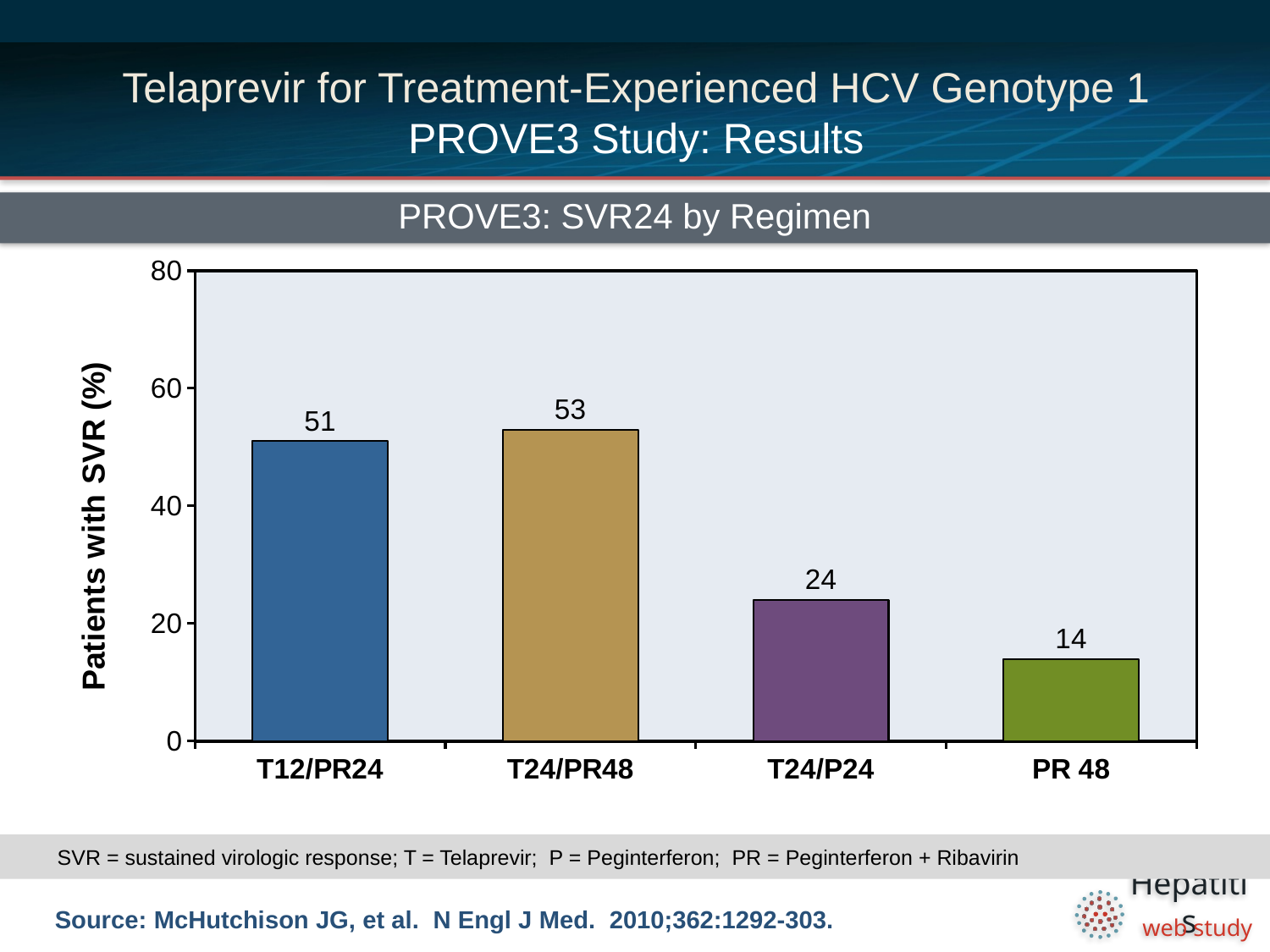
What is the difference between the values for T24/PR48 and PR 48? 39 What is the value for T24/PR48? 53 What is the value for T24/P24? 24 What is the title of the chart? PROVE3: SVR24 by Regimen How many regimens are shown on the chart? 4 What kind of chart is shown on the slide? Bar chart What is the value for T12/PR24? 51 Which regimen has the lowest percentage of patients with SVR? PR 48 What is the value for PR 48? 14 Which regimen has the highest percentage of patients with SVR? T24/PR48 Which is larger, the value for T24/P24 or the value for PR 48? T24/P24 What is the difference between the values for T12/PR24 and T24/P24? 27